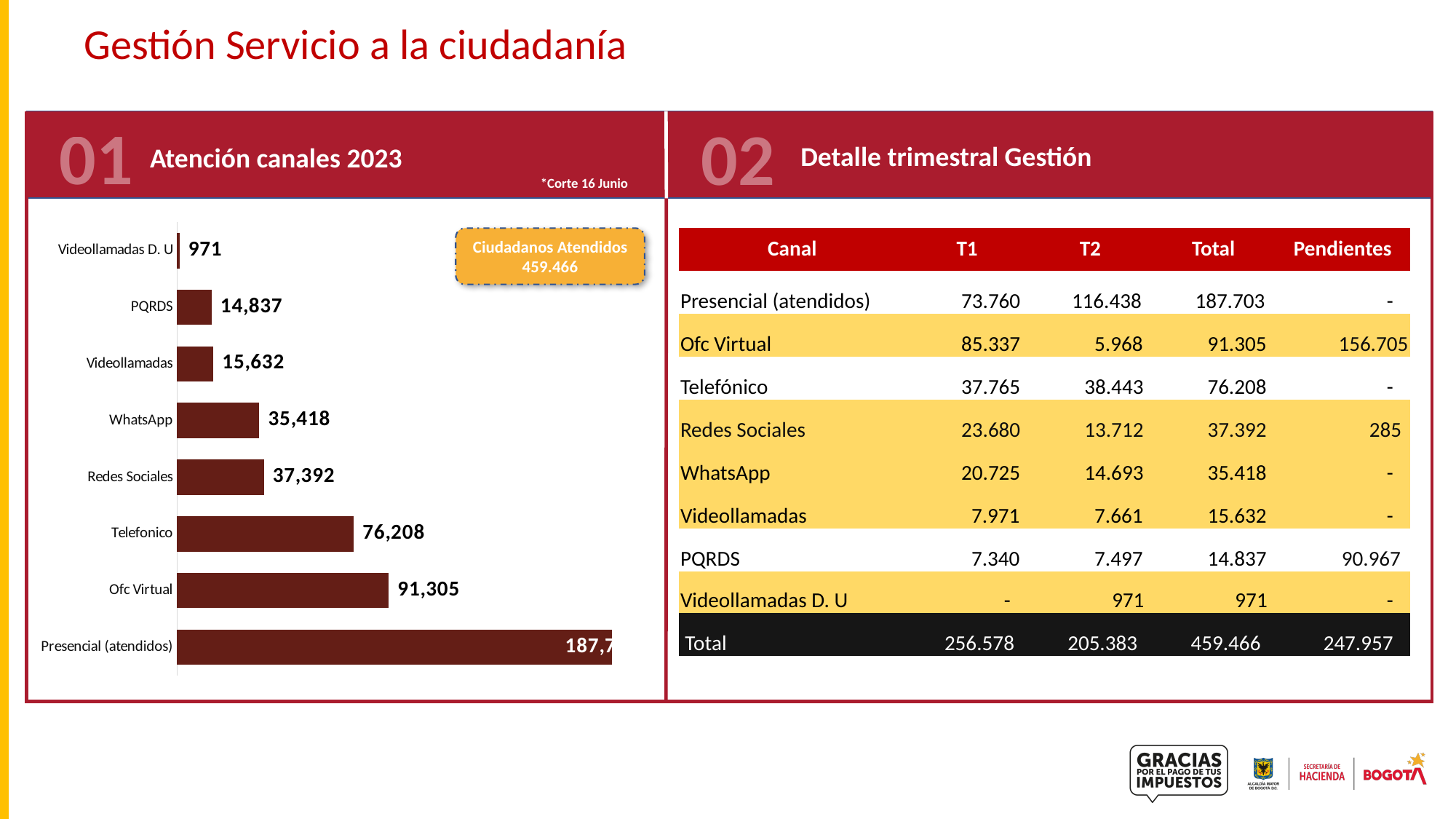
In the Atención canales 2023 chart, what is the difference between Videollamadas and PQRDS? 795 What total number of Ciudadanos Atendidos is shown in the box on the Atención canales 2023 chart? 459.466 How many categories are shown in the Atención canales 2023 chart? 8 Which category has the lowest value in the Atención canales 2023 chart? Videollamadas D. U What kind of chart is the Atención canales 2023 chart? Bar chart In the Atención canales 2023 chart, which is larger: Redes Sociales or WhatsApp? Redes Sociales In the Atención canales 2023 chart, what is the difference between Ofc Virtual and Telefonico? 15,097 What is the value for WhatsApp in the Atención canales 2023 chart? 35,418 What is the value for Telefonico in the Atención canales 2023 chart? 76,208 Which category has the highest value in the Atención canales 2023 chart? Presencial (atendidos) What is the value for Ofc Virtual in the Atención canales 2023 chart? 91,305 What is the value for Videollamadas D. U in the Atención canales 2023 chart? 971